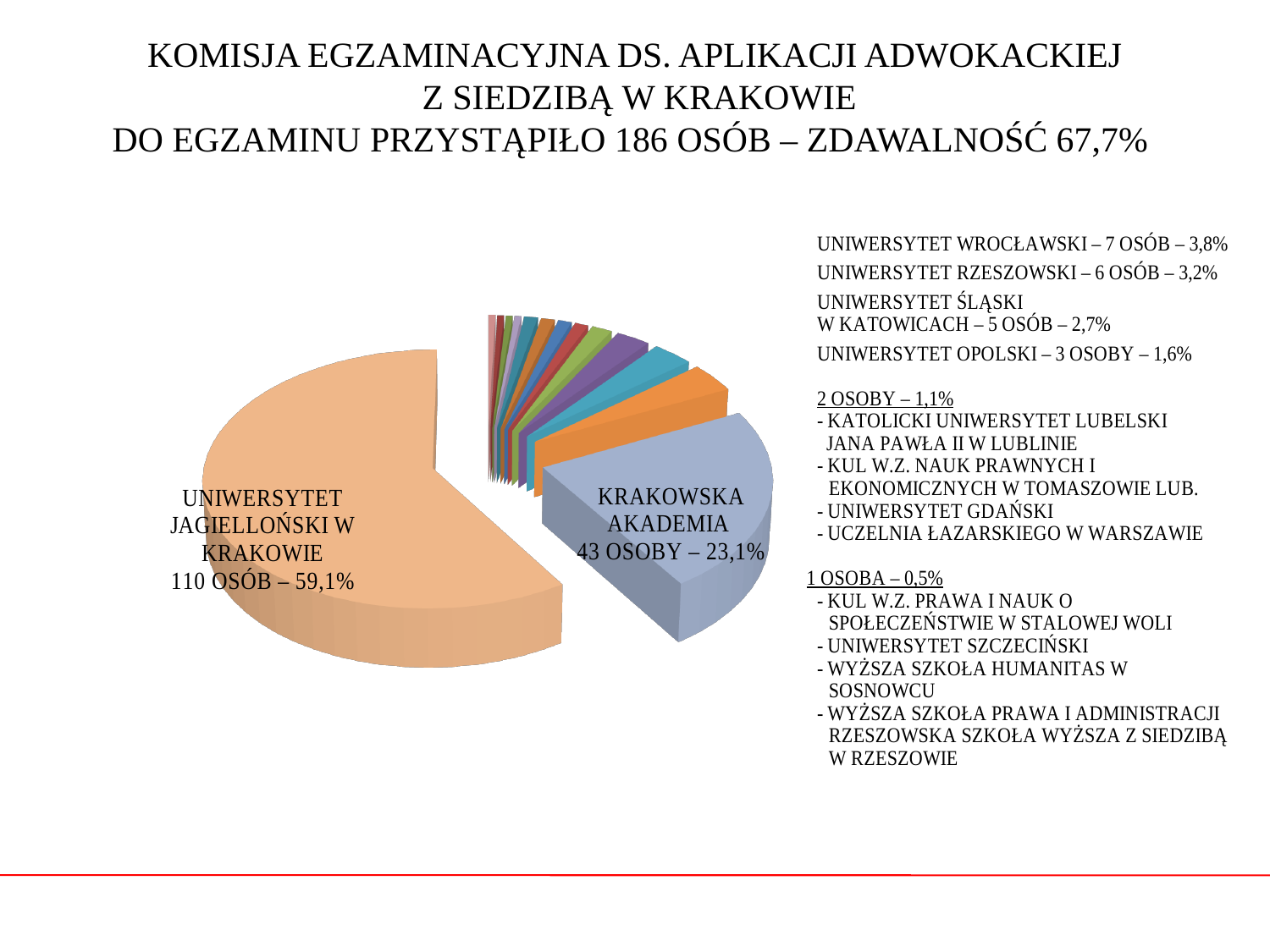
What share of the pie does Uniwersytet Jagielloński w Krakowie represent? 59,1% How many people from Uniwersytet Jagielloński w Krakowie took the exam according to the chart? 110 OSÓB What percentage of the pie is the Krakowska Akademia slice? 23,1% According to the slide title, how many people took the exam in total? 186 What percentage share is listed for Uniwersytet Opolski? 1,6% Which has more people, Uniwersytet Rzeszowski or Uniwersytet Śląski w Katowicach? Uniwersytet Rzeszowski Which institution has the largest slice of the pie? Uniwersytet Jagielloński w Krakowie How many people from Uniwersytet Wrocławski took the exam? 7 OSÓB How many institutions are listed with 2 people (2 OSOBY – 1,1%)? 4 How many people from Krakowska Akademia took the exam? 43 OSOBY What is the difference in number of people between Uniwersytet Jagielloński w Krakowie and Krakowska Akademia? 67 What kind of chart is shown on the slide? pie chart